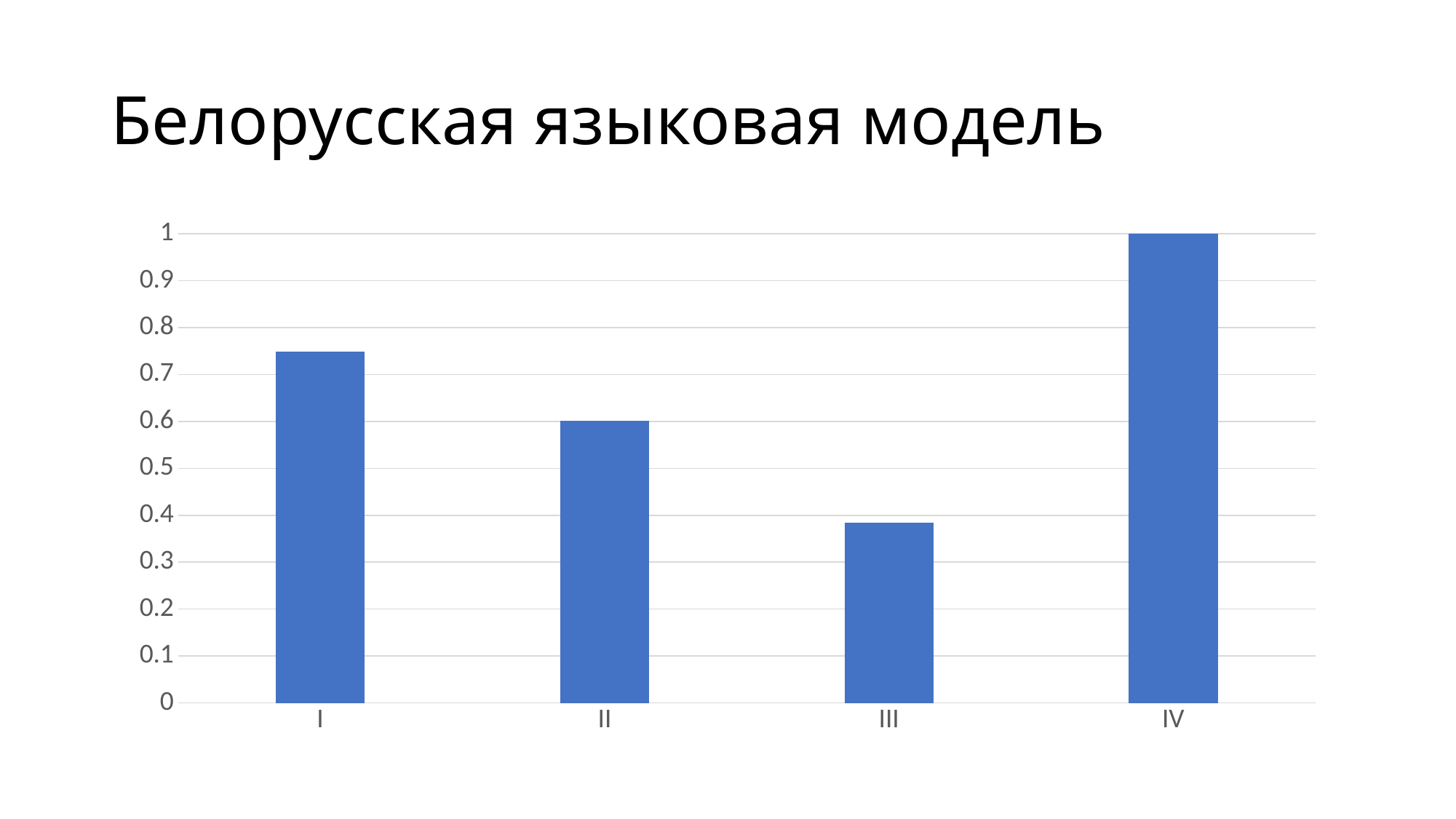
How many categories are shown on the x axis of the chart? 4 Which is larger, the value for I or the value for II? I Which is larger, the value for III or the value for IV? IV What is the value for category IV? 1 Is the value for category III greater or less than 0.4? less Is the value for category I greater or less than 0.7? greater What is the title shown on the slide above the chart? Белорусская языковая модель Which category has the highest bar in the chart? IV What kind of chart is shown on the slide? bar chart Which category has the lowest bar in the chart? III